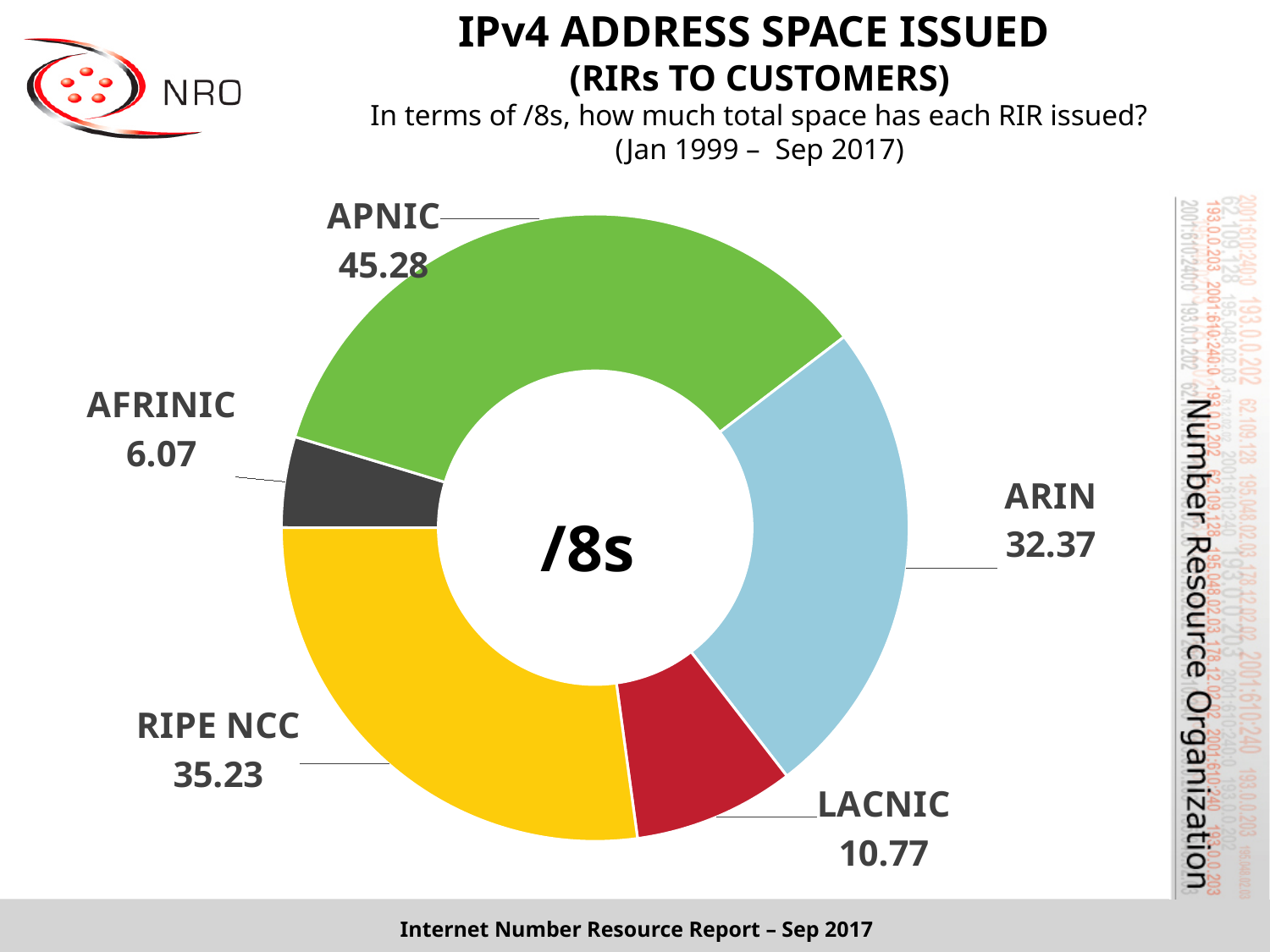
What is the difference in /8s between LACNIC and AFRINIC? 4.70 What kind of chart is shown on the slide? Pie chart (doughnut) What colour is the RIPE NCC slice? Yellow What value is shown for AFRINIC? 6.07 Which RIR has issued the least IPv4 address space in /8s? AFRINIC What value is shown for APNIC in the pie chart? 45.28 How many RIRs are shown as slices in the chart? 5 What value is shown for LACNIC? 10.77 How many /8s has ARIN issued according to the chart? 32.37 Which has issued more /8s, RIPE NCC or ARIN? RIPE NCC What is the difference in /8s between APNIC and ARIN? 12.91 Which RIR has issued the most IPv4 address space in /8s? APNIC